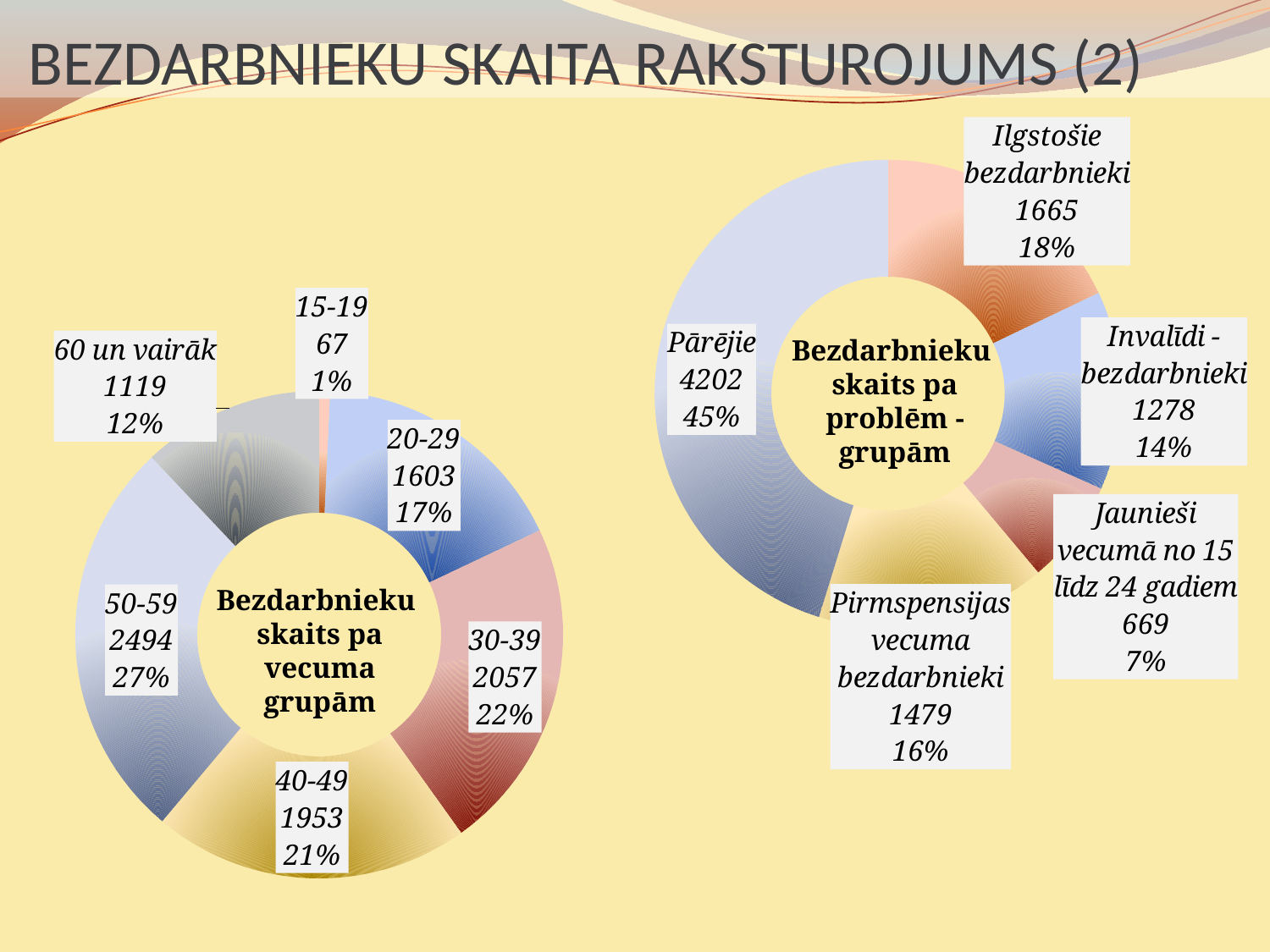
In the right chart (Bezdarbnieku skaits pa problēm-grupām), what is the value for Pārējie? 4202 In the left chart (Bezdarbnieku skaits pa vecuma grupām), what is the difference between the values for 30-39 and 40-49? 104 In the left chart (Bezdarbnieku skaits pa vecuma grupām), what percentage share does the 30-39 age group have? 22% In the left chart (Bezdarbnieku skaits pa vecuma grupām), which age group has the lowest value? 15-19 In the left chart (Bezdarbnieku skaits pa vecuma grupām), how many age groups are shown? 6 In the right chart (Bezdarbnieku skaits pa problēm-grupām), which is larger: Ilgstošie bezdarbnieki or Pirmspensijas vecuma bezdarbnieki? Ilgstošie bezdarbnieki What kind of chart is the right chart (Bezdarbnieku skaits pa problēm-grupām)? Doughnut chart In the left chart (Bezdarbnieku skaits pa vecuma grupām), what is the value for the 50-59 age group? 2494 In the right chart (Bezdarbnieku skaits pa problēm-grupām), what percentage share do Invalīdi-bezdarbnieki have? 14% In the right chart (Bezdarbnieku skaits pa problēm-grupām), which group has the smallest value? Jaunieši vecumā no 15 līdz 24 gadiem In the right chart (Bezdarbnieku skaits pa problēm-grupām), what is the difference between the values for Ilgstošie bezdarbnieki and Invalīdi-bezdarbnieki? 387 In the left chart (Bezdarbnieku skaits pa vecuma grupām), which age group has the highest value? 50-59